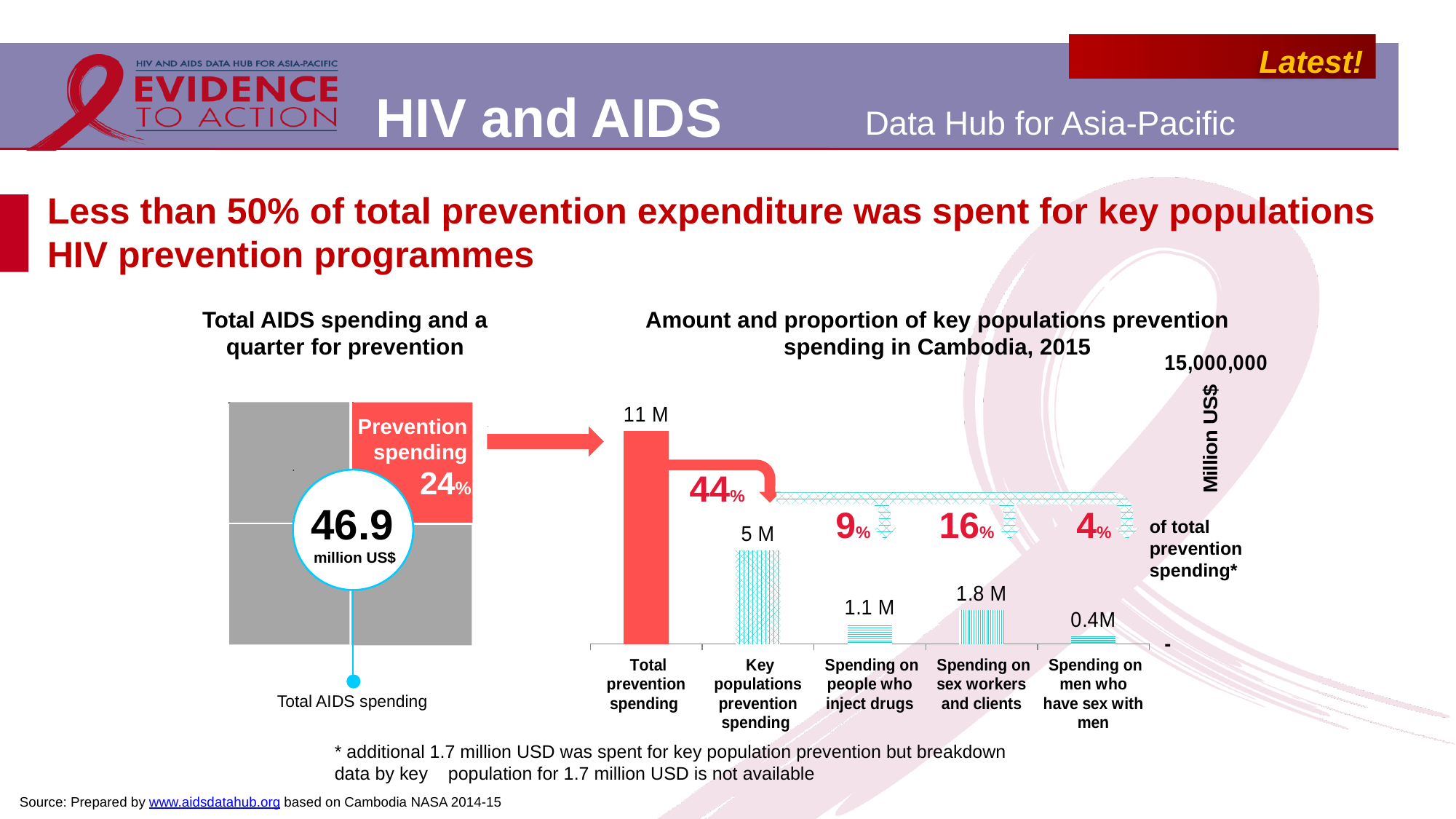
In the chart 'Amount and proportion of key populations prevention spending in Cambodia, 2015', what is the value for Spending on men who have sex with men? 0.4M In the chart 'Amount and proportion of key populations prevention spending in Cambodia, 2015', which category has the lowest value? Spending on men who have sex with men In the chart 'Amount and proportion of key populations prevention spending in Cambodia, 2015', what is the difference between Spending on sex workers and clients and Spending on people who inject drugs? 0.7 M In the chart 'Amount and proportion of key populations prevention spending in Cambodia, 2015', which category has the highest value? Total prevention spending How many categories are shown in the chart 'Amount and proportion of key populations prevention spending in Cambodia, 2015'? 5 In the chart 'Total AIDS spending and a quarter for prevention', what is the total AIDS spending? 46.9 million US$ In the chart 'Amount and proportion of key populations prevention spending in Cambodia, 2015', what percentage of total prevention spending is spent on people who inject drugs? 9% What kind of chart is 'Amount and proportion of key populations prevention spending in Cambodia, 2015'? Bar chart In the chart 'Amount and proportion of key populations prevention spending in Cambodia, 2015', what is the value for Spending on sex workers and clients? 1.8 M In the chart 'Amount and proportion of key populations prevention spending in Cambodia, 2015', what is the value for Key populations prevention spending? 5 M In the chart 'Amount and proportion of key populations prevention spending in Cambodia, 2015', which is larger: Spending on sex workers and clients or Spending on people who inject drugs? Spending on sex workers and clients In the chart 'Amount and proportion of key populations prevention spending in Cambodia, 2015', what is the value for Total prevention spending? 11 M